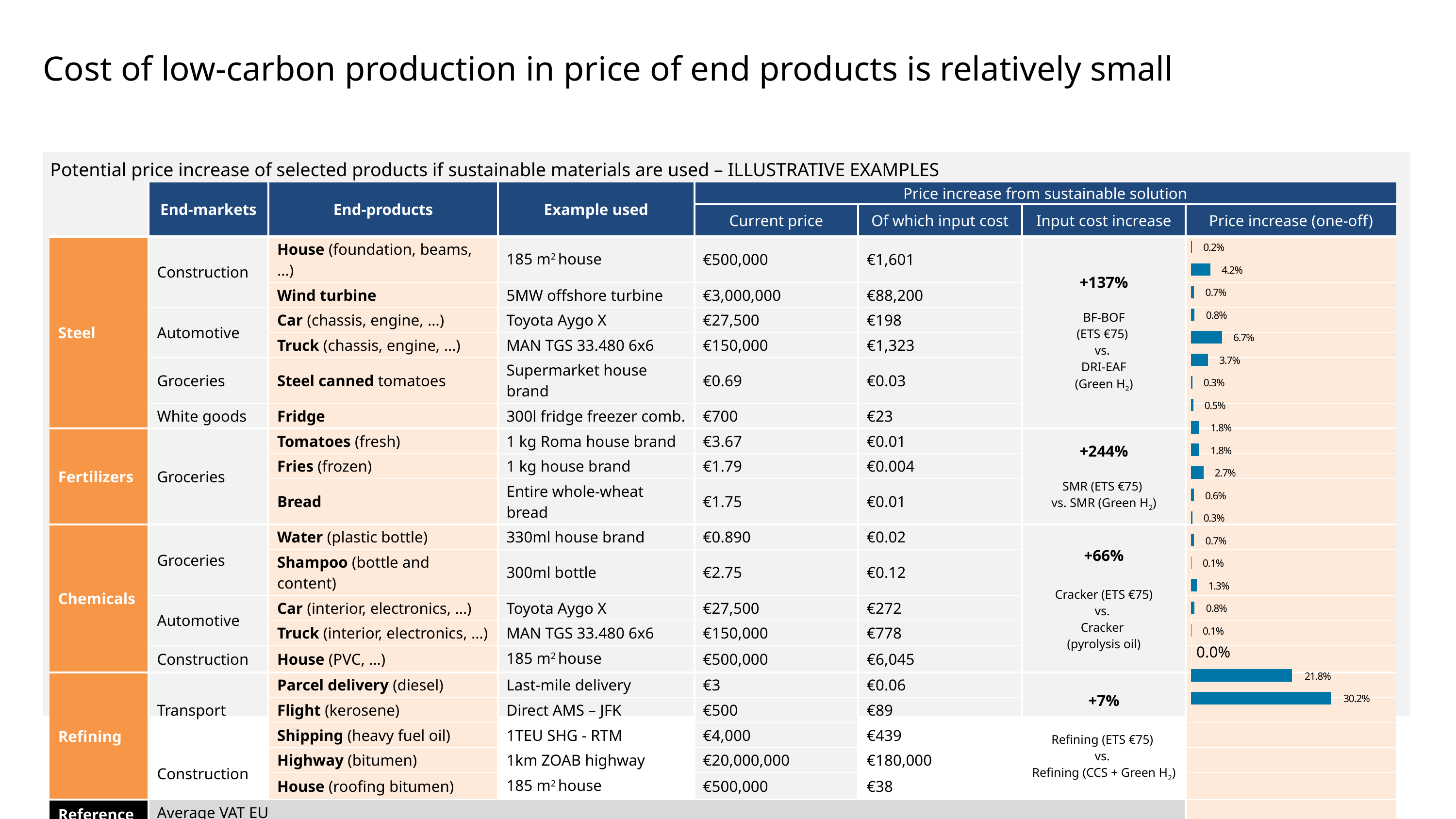
What is the smallest value labelled in the 'Price increase (one-off)' bar chart? 0.0% What colour are the bars in the 'Price increase (one-off)' chart? blue What is the second-largest value in the 'Price increase (one-off)' bar chart? 21.8% What is the largest value shown in the 'Price increase (one-off)' bar chart? 30.2% How many bars in the 'Price increase (one-off)' chart have values above 10%? 2 What is the column heading above the bar chart on the right of the table? Price increase (one-off) What is the third-largest value in the 'Price increase (one-off)' bar chart? 6.7% How many bars in the 'Price increase (one-off)' chart have values above 5%? 3 In the 'Price increase (one-off)' chart, which is larger: the bar labelled 6.7% or the bar labelled 4.2%? 6.7% What is the difference between the two largest bars (30.2% and 21.8%) in the 'Price increase (one-off)' chart? 8.4% How many bars in the 'Price increase (one-off)' chart are labelled 1.8%? 2 What kind of chart is shown in the 'Price increase (one-off)' column? bar chart